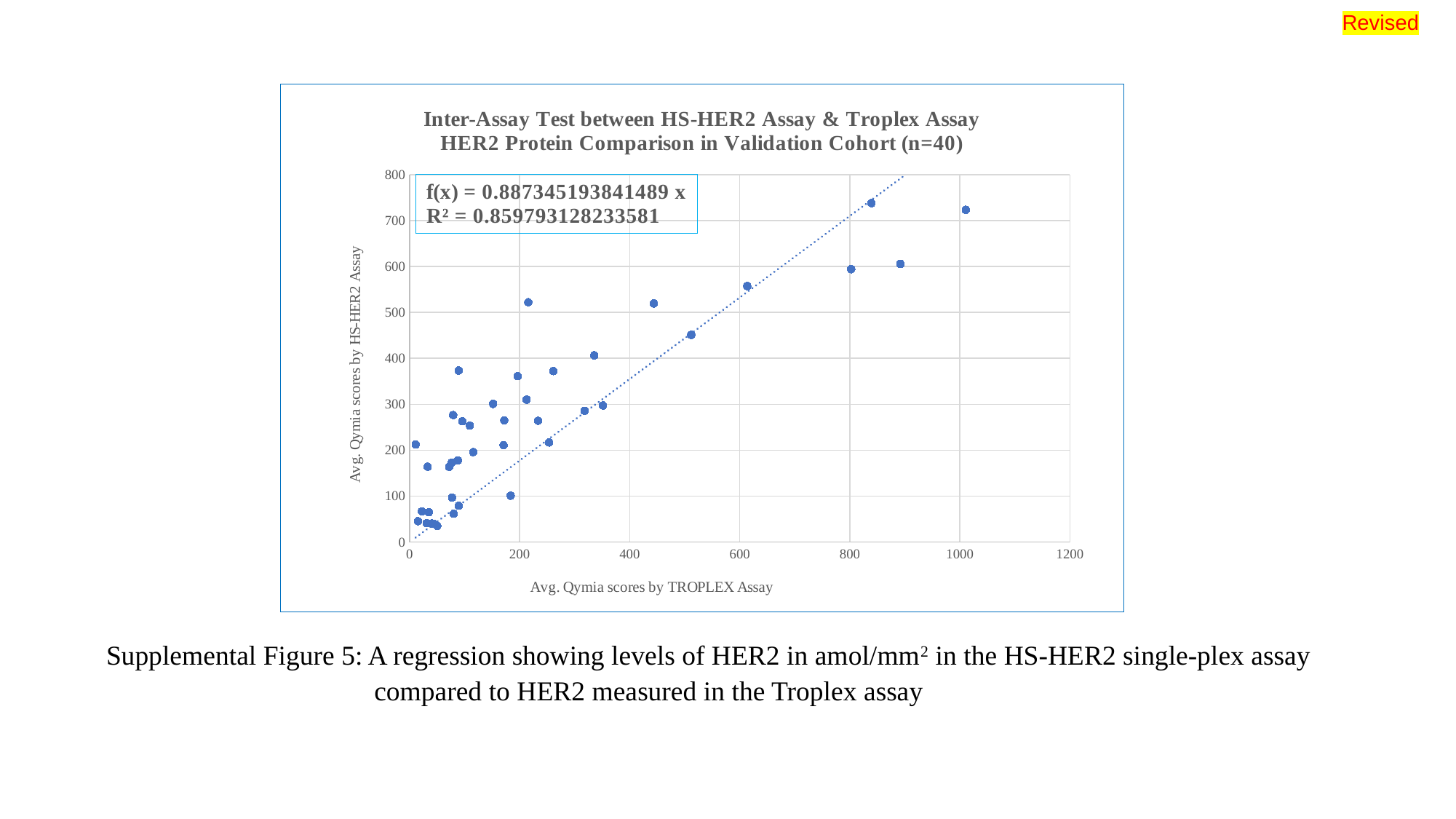
What kind of chart is shown on the slide? Scatter chart Is the y value of the point at a TROPLEX Assay score of about 600 greater or less than 600? less According to the chart title, how many samples are in the validation cohort? 40 What is the label of the y axis? Avg. Qymia scores by HS-HER2 Assay Is the y value of the point at a TROPLEX Assay score of about 440 greater or less than 500? greater What is the maximum value shown on the x axis? 1200 Is the y value of the point with the highest TROPLEX Assay score (around 1000) greater or less than 700? greater What is the label of the x axis? Avg. Qymia scores by TROPLEX Assay What is the maximum value shown on the y axis? 800 What is the fitted equation f(x) shown on the chart? f(x) = 0.887345193841489 x What is the R² value shown on the chart? 0.859793128233581 Do the HS-HER2 Assay scores generally rise or fall as the TROPLEX Assay scores increase? Rise